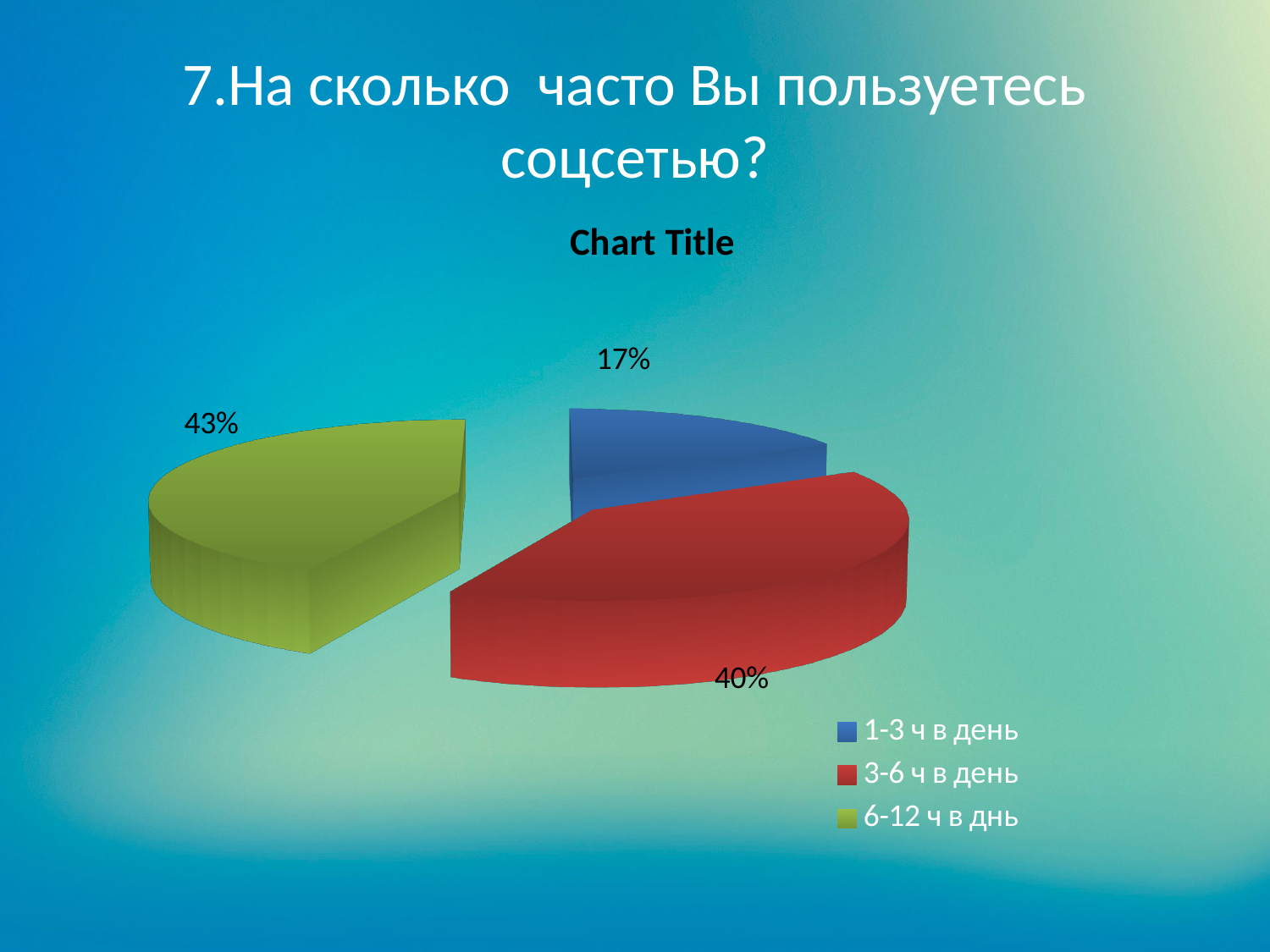
Which slice is larger: "3-6 ч в день" or "1-3 ч в день"? 3-6 ч в день What colour is the slice for "3-6 ч в день"? red Which category has the smallest share of the pie? 1-3 ч в день What percentage of the pie is the slice for "1-3 ч в день"? 17% What percentage of the pie is the slice for "6-12 ч в днь"? 43% How many entries does the legend list? 3 What percentage of the pie is the slice for "3-6 ч в день"? 40% How many slices does the pie chart have? 3 What is the difference in percentage points between the "6-12 ч в днь" slice and the "1-3 ч в день" slice? 26 What kind of chart is shown on the slide? pie chart Which category has the largest share of the pie? 6-12 ч в днь What is the title printed above the pie chart? Chart Title